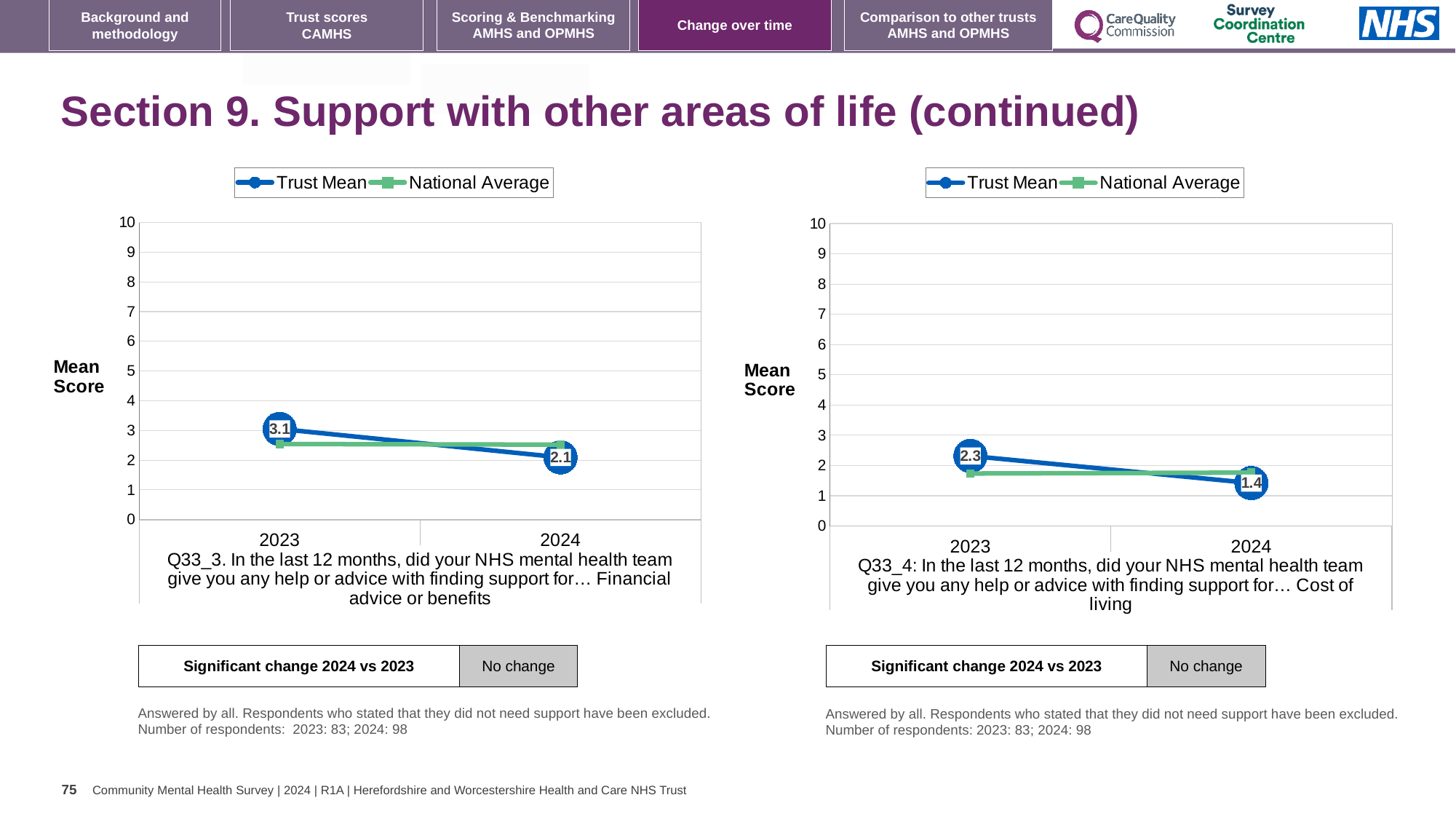
In the left chart (Q33_3), does the Trust Mean rise or fall from 2023 to 2024? Fall In the right chart (Q33_4), what is the difference between the Trust Mean scores for 2023 and 2024? 0.9 What type of chart is used for Q33_3 on the left of the slide? Line chart In the right chart (Q33_4), is the National Average value for 2023 greater or less than 2? less In the left chart (Q33_3), which is higher in 2023, the Trust Mean or the National Average? Trust Mean In the right chart (Q33_4, Cost of living), what is the Trust Mean score for 2023? 2.3 In the left chart (Q33_3, Financial advice or benefits), what is the Trust Mean score for 2024? 2.1 In the right chart (Q33_4, Cost of living), what is the Trust Mean score for 2024? 1.4 In the left chart (Q33_3), is the National Average value for 2023 greater or less than 3? less How many series does the legend of the right chart (Q33_4) list? 2 In the left chart (Q33_3, Financial advice or benefits), what is the Trust Mean score for 2023? 3.1 In the left chart (Q33_3), by how much did the Trust Mean score fall from 2023 to 2024? 1.0